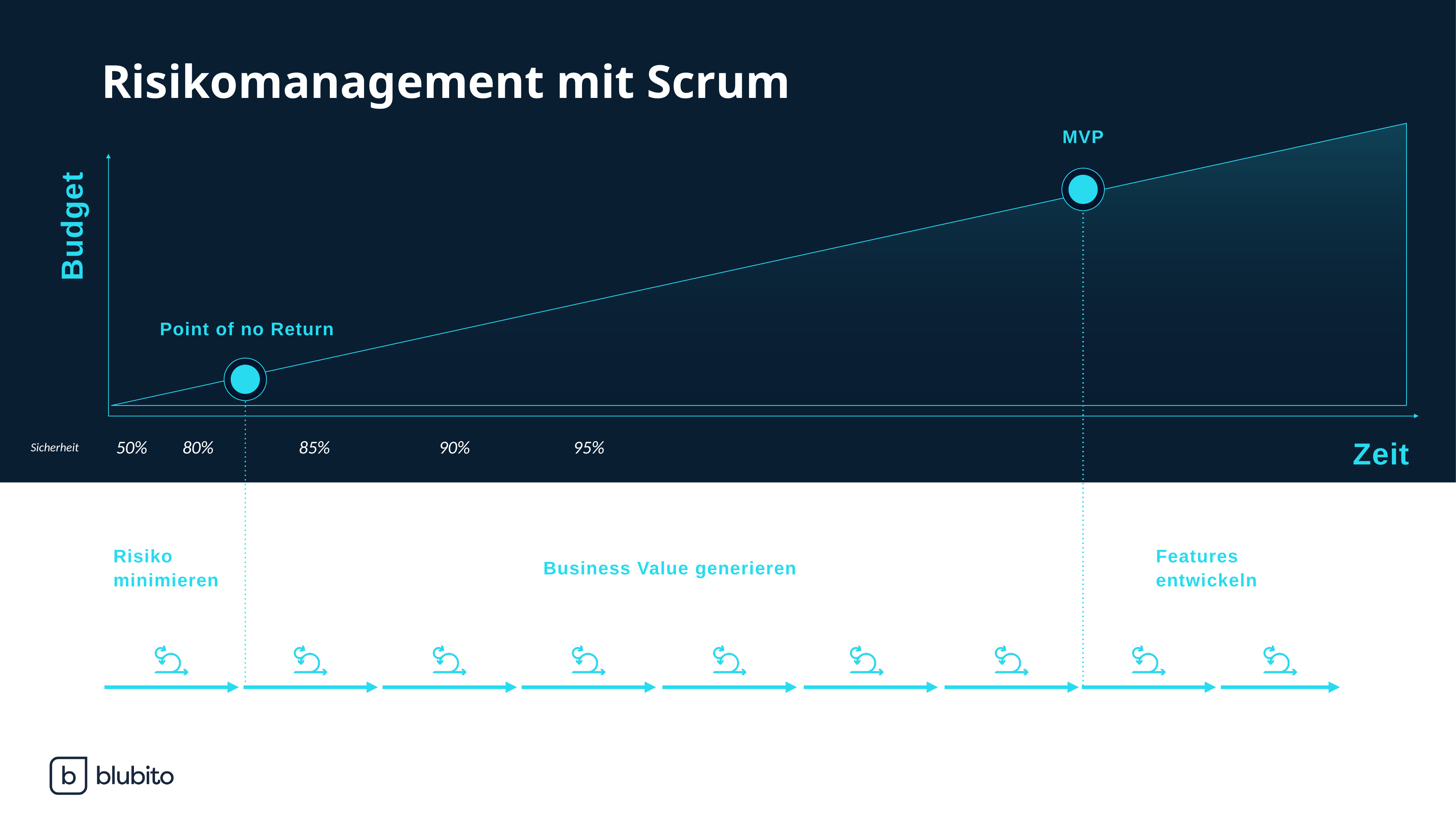
Which marked point is at a higher budget level, Point of no Return or MVP? MVP How many Sicherheit percentage values are printed along the x axis? 5 How many sprint arrows are shown below the chart? 9 What Sicherheit percentage is printed immediately to the left of the Point of no Return? 80% What label is on the vertical axis of the chart? Budget What is the title of the chart on the slide? Risikomanagement mit Scrum What is the highest Sicherheit percentage printed along the x axis? 95% Does the budget line rise or fall as time (Zeit) increases? rise Which marked point comes first along the time axis, Point of no Return or MVP? Point of no Return How many marked points (circles) are on the budget line? 2 What is the lowest Sicherheit percentage printed along the x axis? 50%